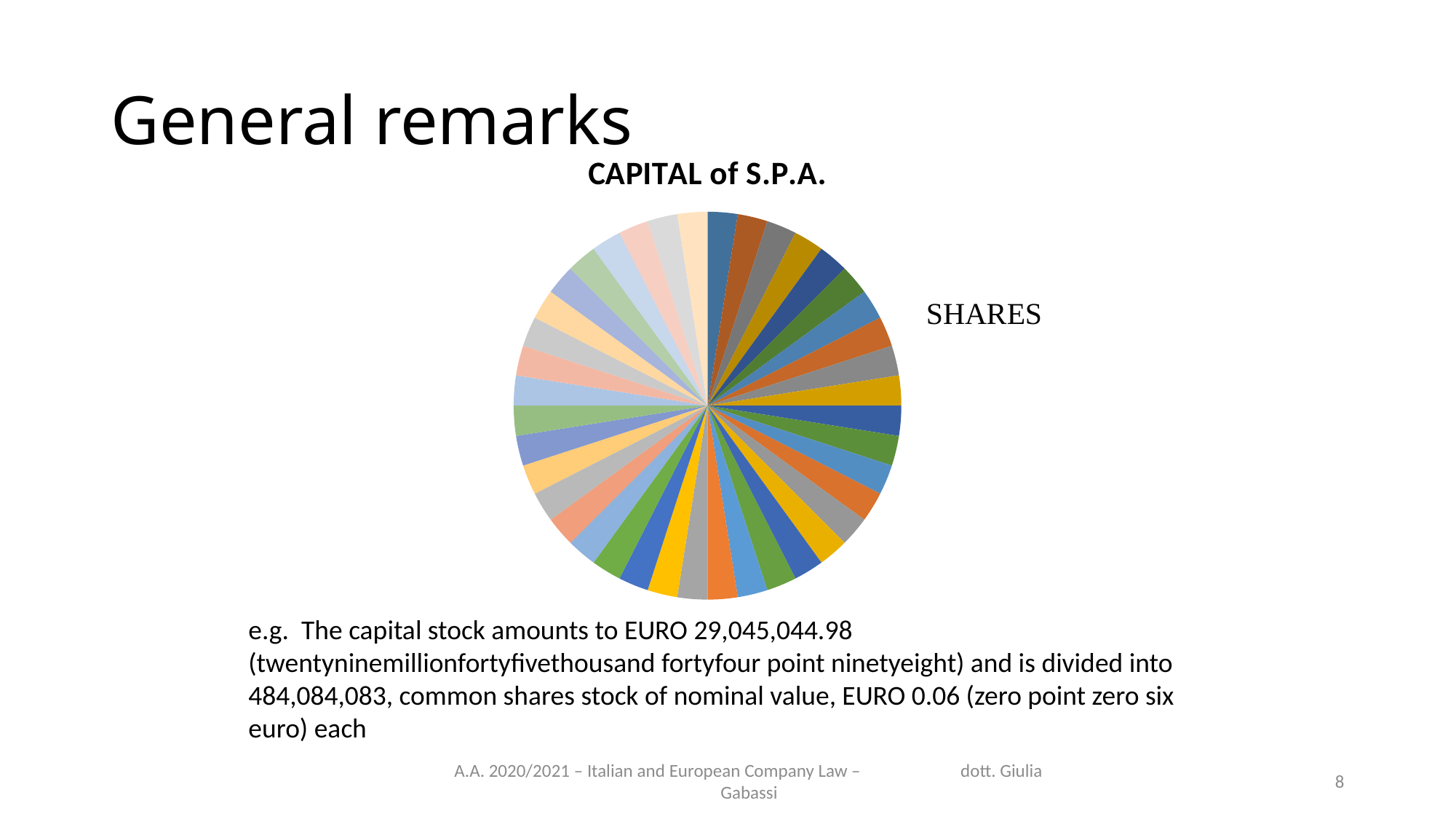
What is the title of the chart on the slide? CAPITAL of S.P.A. Are the slices of the pie chart roughly equal in size or clearly different in size? roughly equal What label appears to the right of the pie chart? SHARES What kind of chart is shown on the slide? pie chart